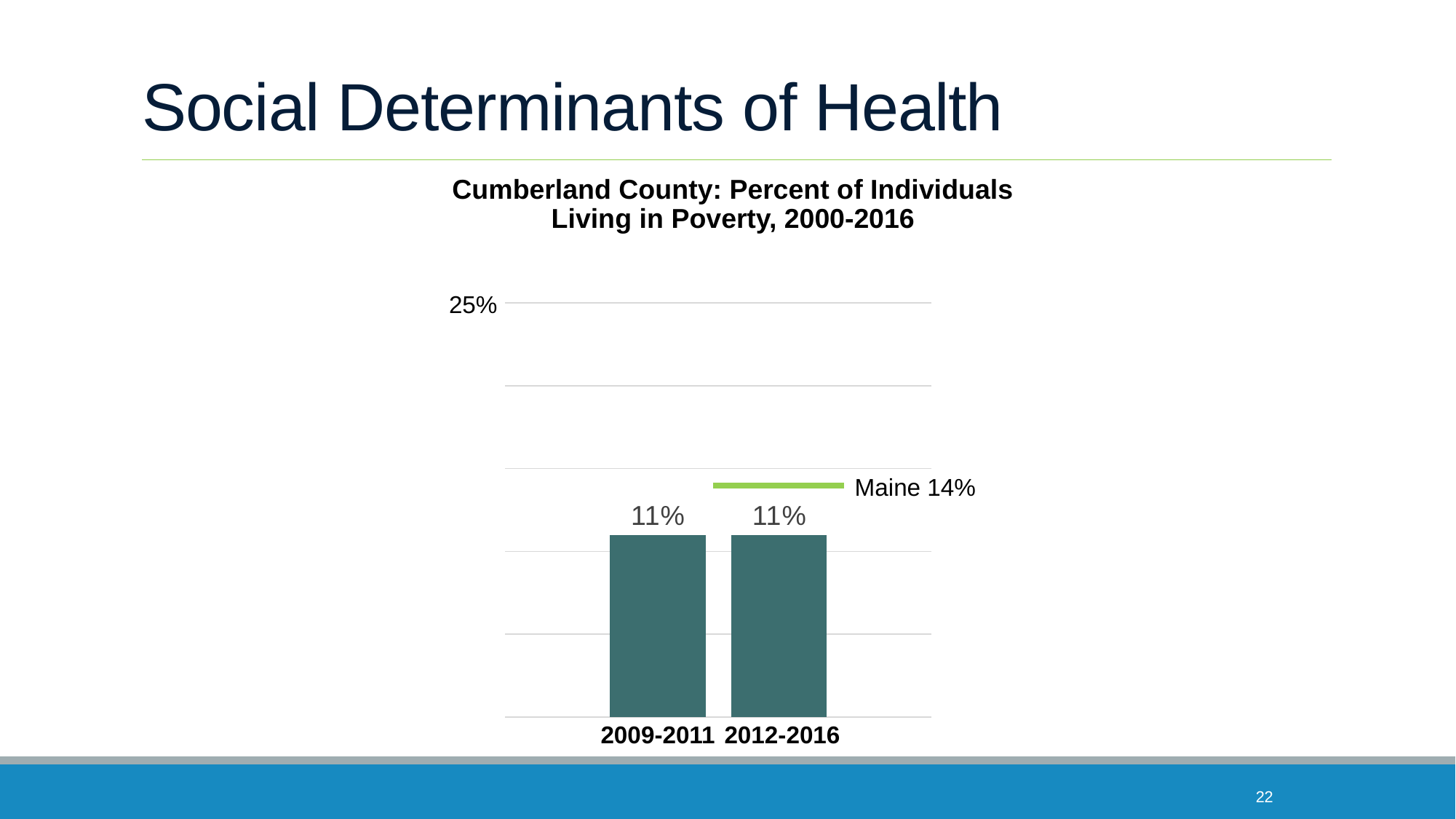
Is the Cumberland County value for 2012-2016 larger or smaller than the Maine value? smaller What kind of chart is shown on the slide? bar chart Is the value for 2009-2011 greater or less than 25%? less How many time periods are shown as bars on the chart? 2 What is the highest value labelled on the vertical axis? 25% What is the difference between the Maine value and the Cumberland County value for 2012-2016? 3% Do the Cumberland County values rise, fall, or stay the same from 2009-2011 to 2012-2016? stay the same What is the percent of individuals living in poverty in Cumberland County for 2009-2011? 11% What is the percent of individuals living in poverty in Cumberland County for 2012-2016? 11% What is the title of the chart? Cumberland County: Percent of Individuals Living in Poverty, 2000-2016 What is the Maine value shown as a reference line on the chart? 14%